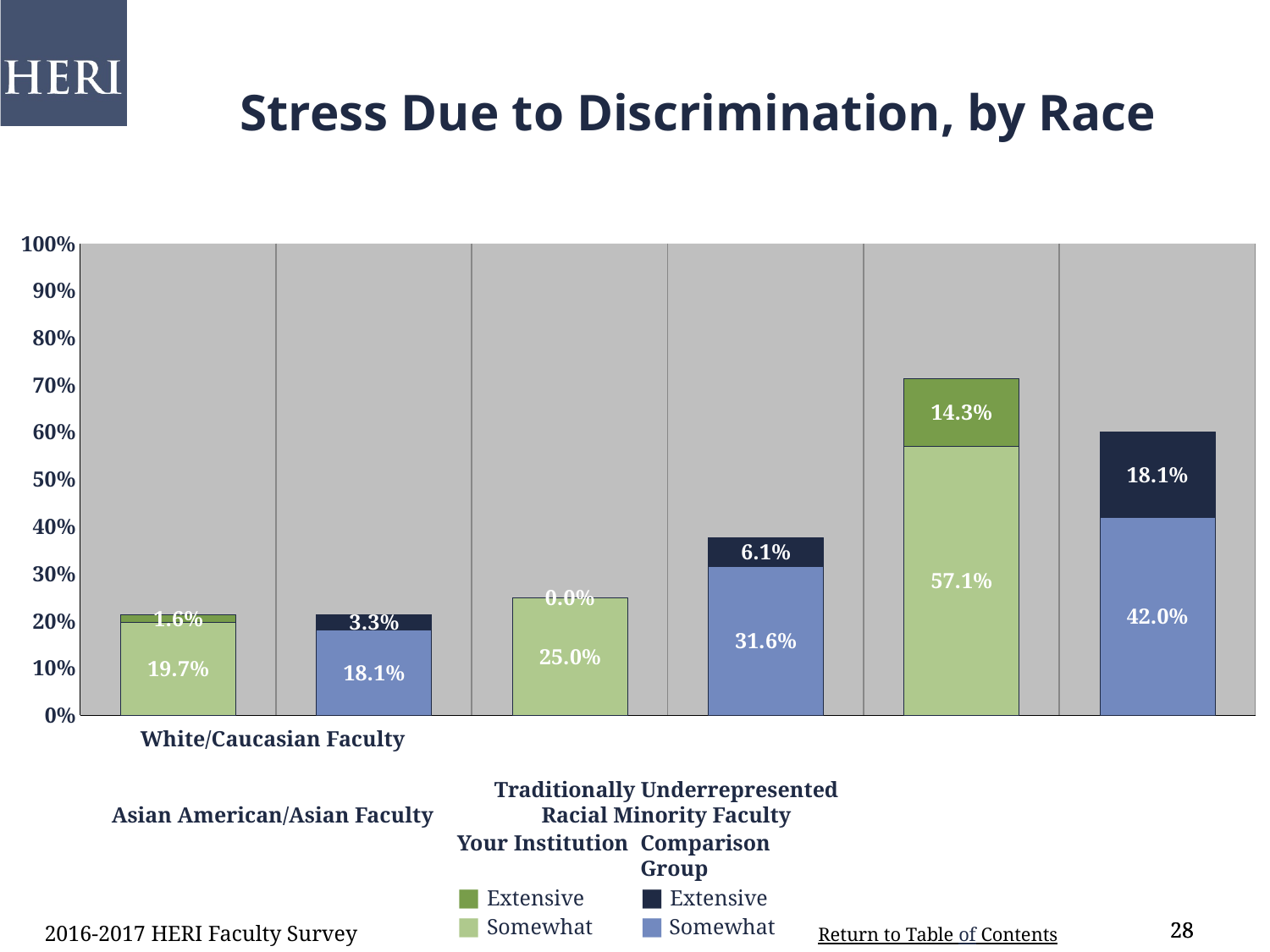
Which is larger for Traditionally Underrepresented Racial Minority Faculty: the Your Institution 'Extensive' value or the Comparison Group 'Extensive' value? Comparison Group 'Extensive' (18.1%) How many series does the legend list? 4 What kind of chart is shown on the slide? stacked bar chart What is the 'Somewhat' value for Your Institution among Traditionally Underrepresented Racial Minority Faculty? 57.1% What is the difference between the Comparison Group 'Somewhat' value and the Your Institution 'Somewhat' value for Asian American/Asian Faculty? 6.6% What is the total of the Comparison Group stacked bar for White/Caucasian Faculty? 21.4% What is the title of the chart? Stress Due to Discrimination, by Race What is the 'Extensive' value for Your Institution among Asian American/Asian Faculty? 0.0% What is the 'Somewhat' value for Your Institution among White/Caucasian Faculty? 19.7% Which race group has the highest Your Institution 'Somewhat' value? Traditionally Underrepresented Racial Minority Faculty What is the 'Extensive' value for the Comparison Group among Asian American/Asian Faculty? 6.1% What is the total of the Your Institution stacked bar for Traditionally Underrepresented Racial Minority Faculty? 71.4%